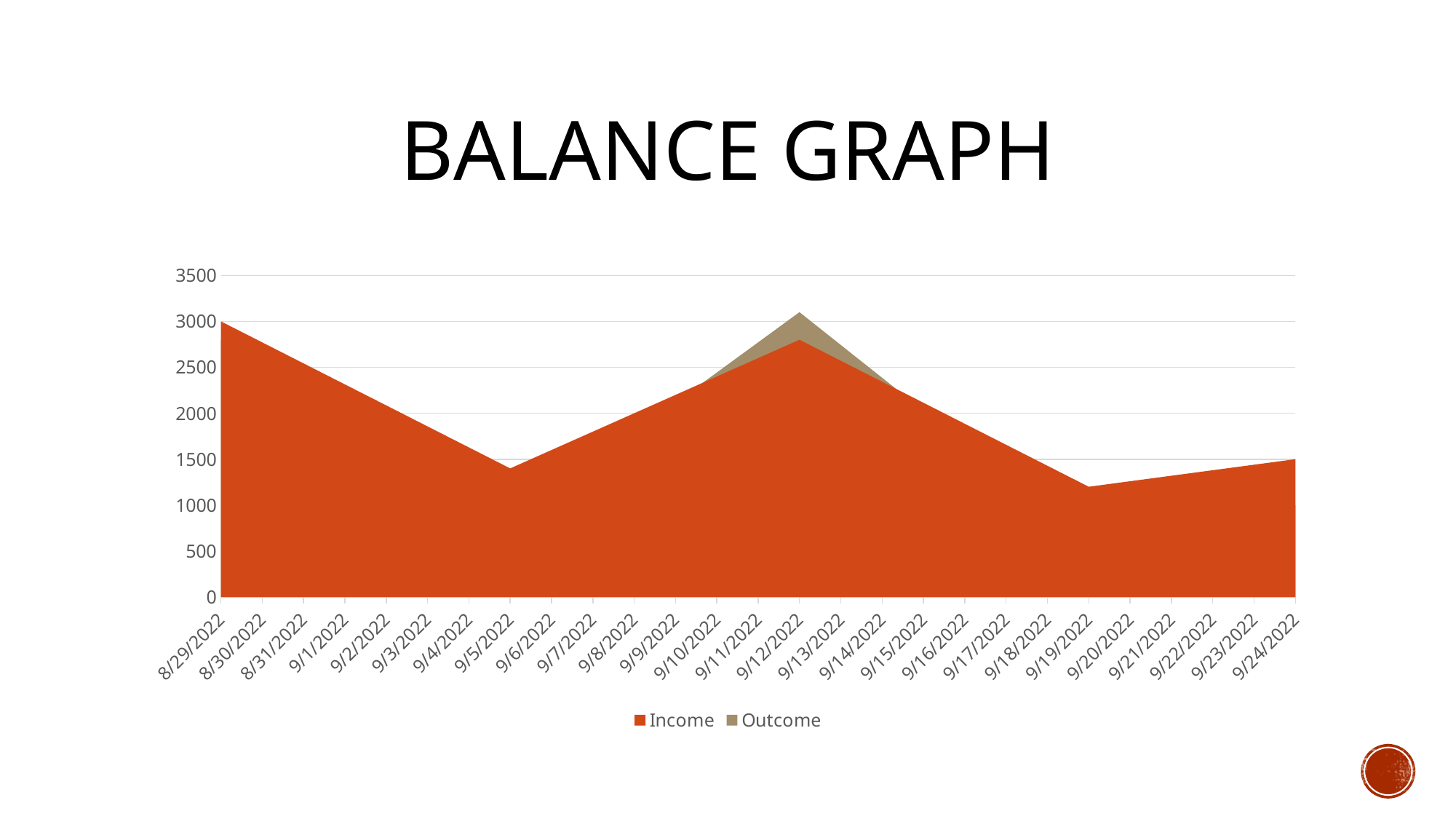
How many series does the legend list? 2 Is the Income value for 9/5/2022 greater or less than 2000? less What kind of chart is shown on the slide? Area chart Does the Income value rise or fall from 8/29/2022 to 9/5/2022? fall Is the Outcome value for 9/12/2022 greater or less than 2500? greater Is the Income value for 8/29/2022 greater or less than 2500? greater What are the two series named in the legend? Income and Outcome What is the title of the chart? BALANCE GRAPH Which date has the lowest Income value? 9/19/2022 How many dates are shown on the x axis? 27 Which date has the highest Income value? 8/29/2022